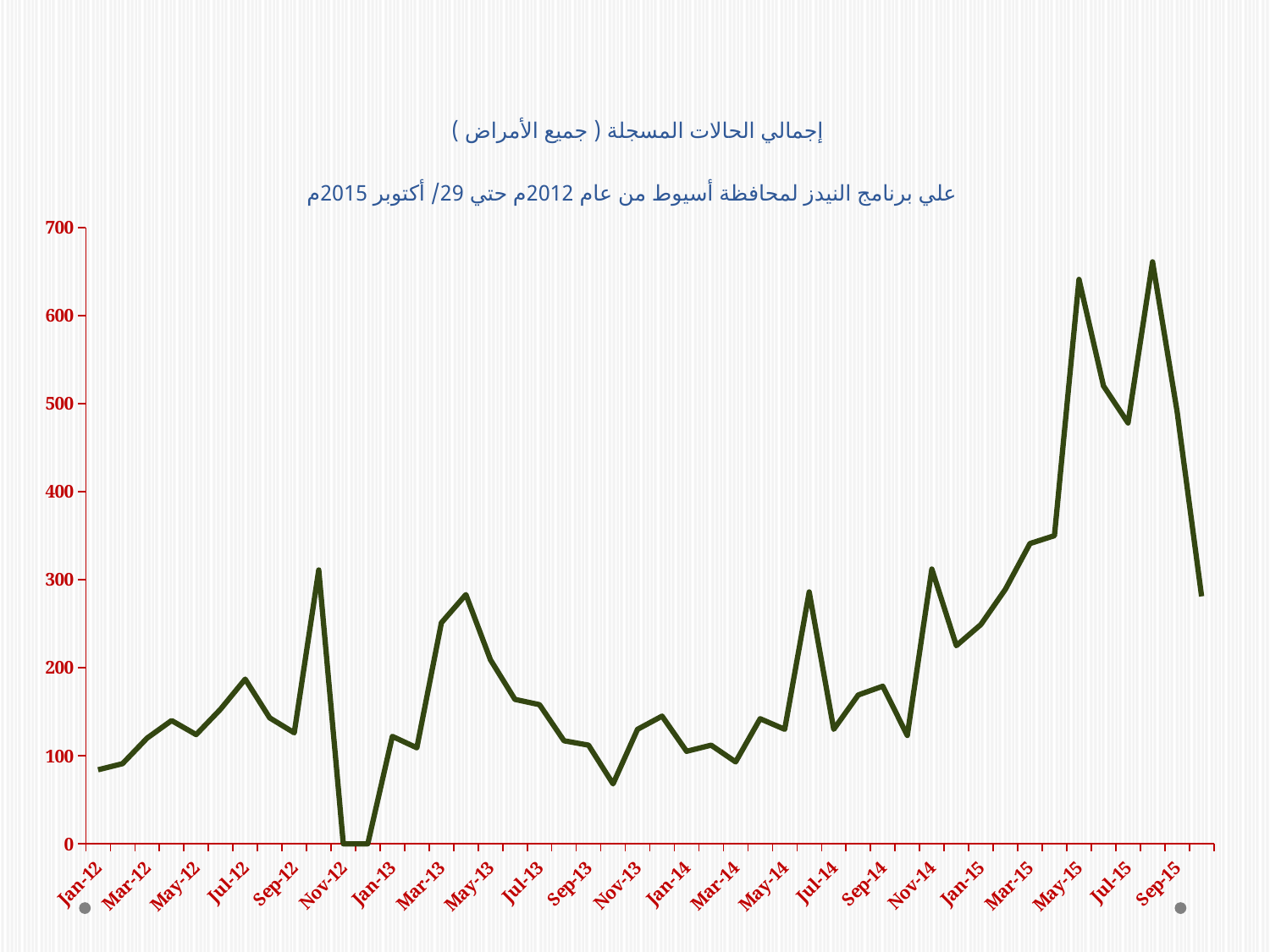
Is the value for Sep-15 greater or less than 600? less How many month labels are printed along the x axis? 23 Is the value for Jan-12 greater or less than 100? less Which is larger, the value for Sep-15 or the value for Oct-12? Sep-15 What kind of chart is shown on the slide? line chart Is the value for May-15 greater or less than 600? greater What is the highest value shown on the vertical axis? 700 What is the value for Nov-12? 0 Overall, do the values rise or fall from Jan-12 to Sep-15? rise